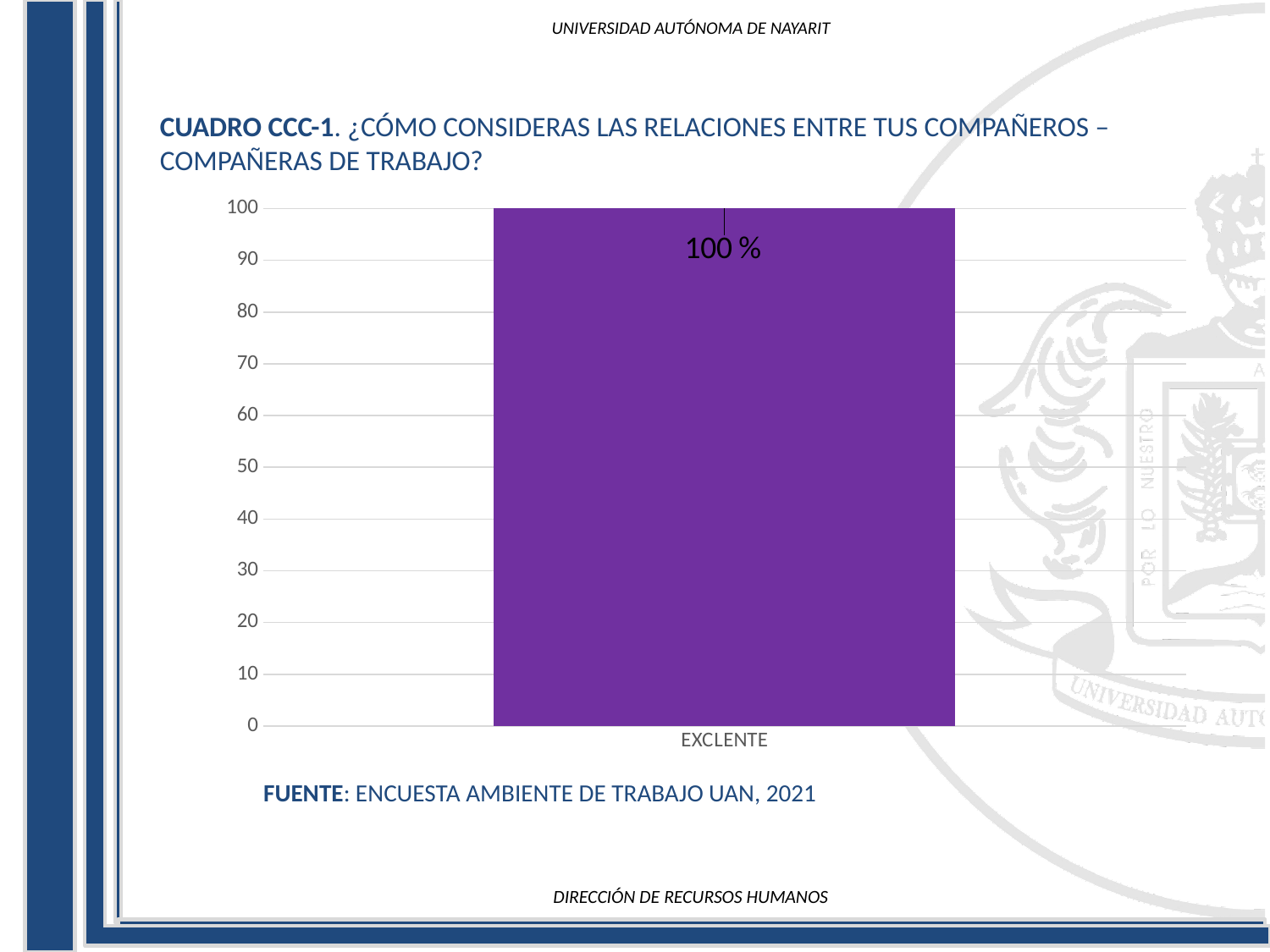
What is the value shown for EXCLENTE? 100 % Is the value for EXCLENTE greater or less than 50? greater What kind of chart is shown on the slide? bar chart Is the value for EXCLENTE greater or less than 90? greater How many categories are plotted on the x axis? 1 What is the maximum value shown on the y axis? 100 What is the label of the only category on the x axis? EXCLENTE